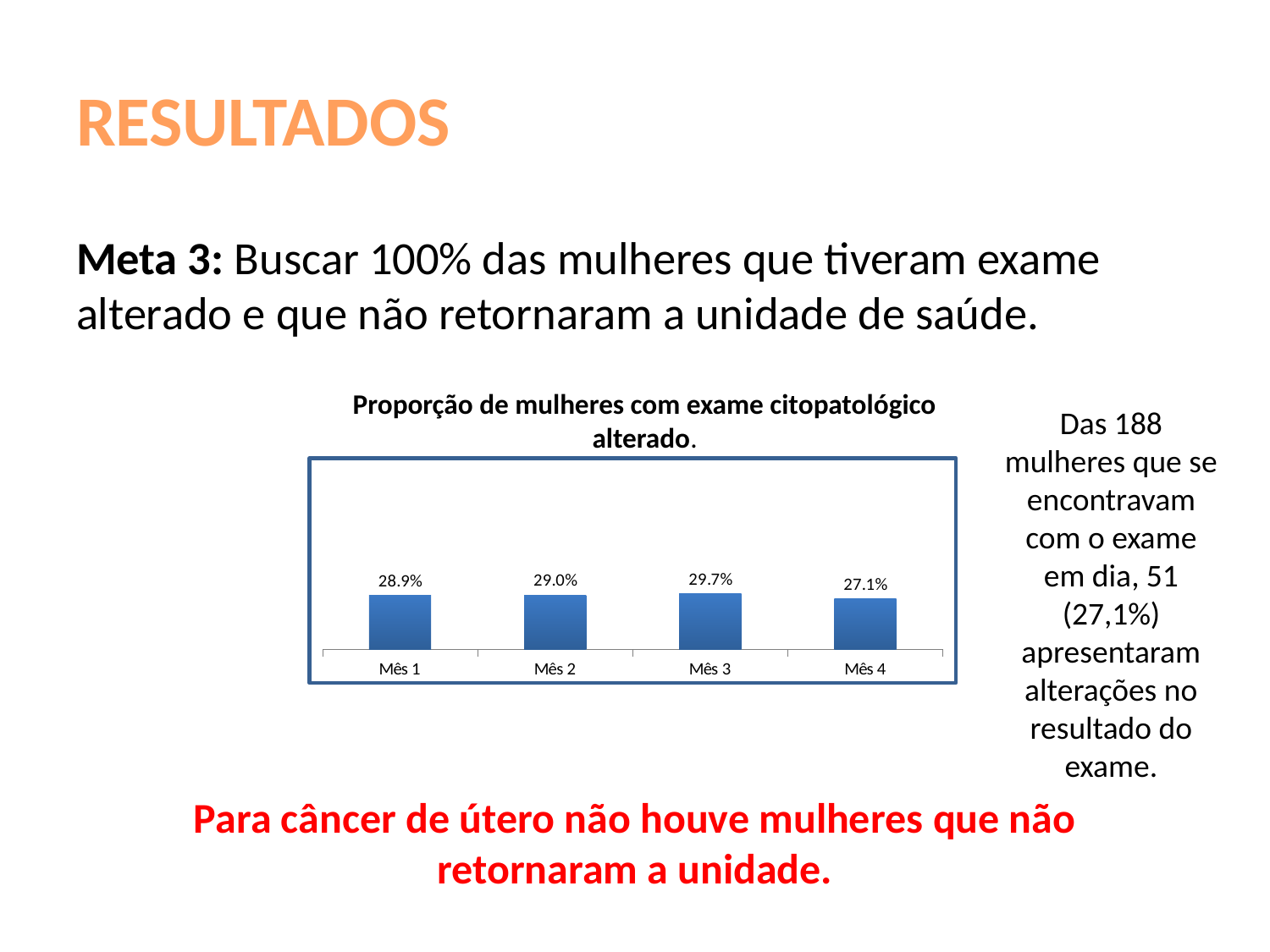
What is the difference between the values for Mês 3 and Mês 4? 2.6 percentage points How many months (categories) are shown in the chart? 4 What is the value for Mês 1 in the chart? 28.9% What is the value for Mês 2 in the chart? 29.0% What kind of chart is shown on the slide? Bar chart Which month has the lowest proportion in the chart? Mês 4 Does the value rise or fall from Mês 3 to Mês 4? Fall Which is larger, the value for Mês 3 or the value for Mês 4? Mês 3 What is the value for Mês 4 in the chart? 27.1% What is the title of the chart? Proporção de mulheres com exame citopatológico alterado. What is the value for Mês 3 in the chart? 29.7% Which month has the highest proportion in the chart? Mês 3